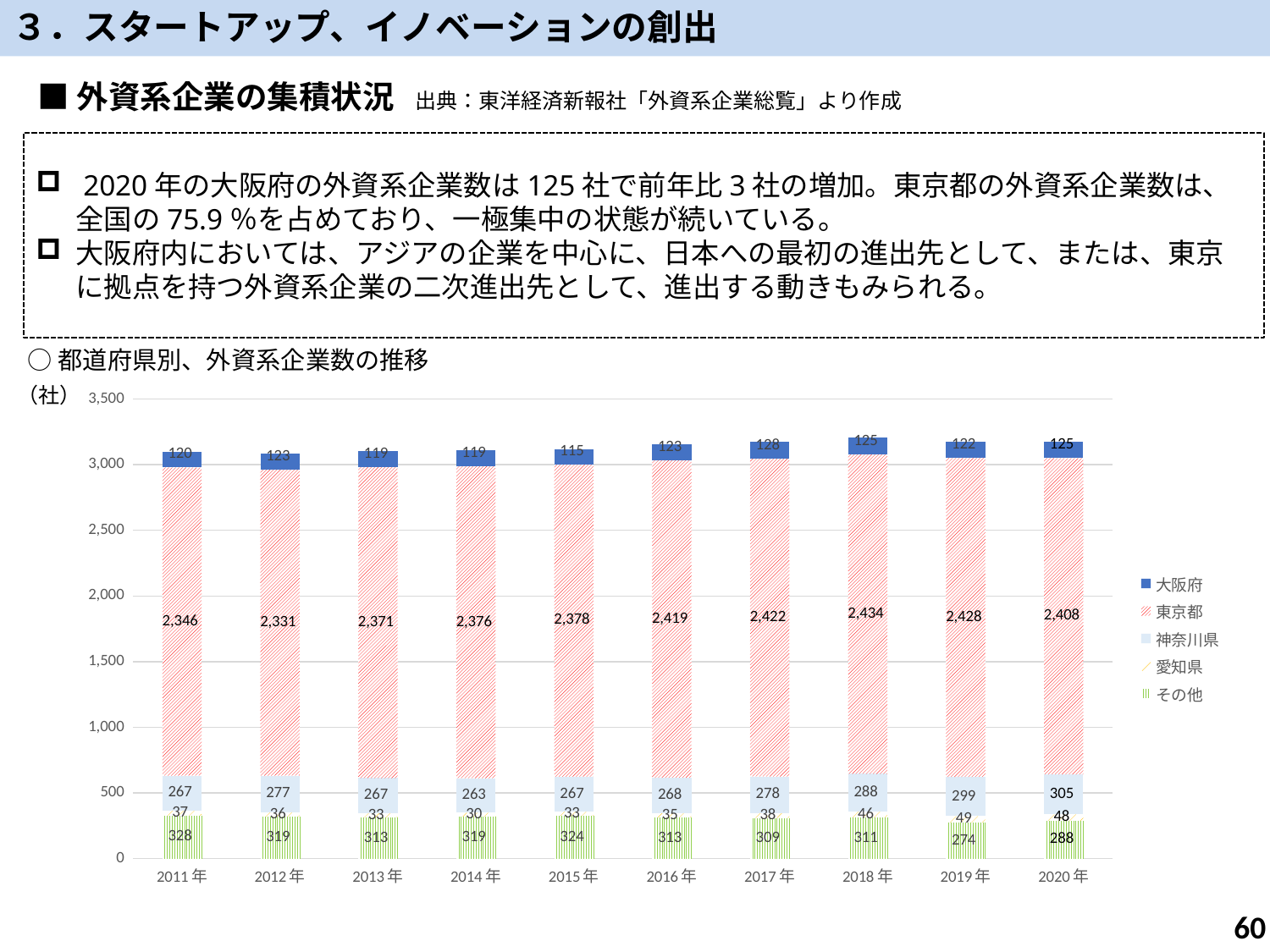
What is the value for その他 in 2019年? 274 In which year is the value for 大阪府 the lowest? 2015年 How many years are shown on the x axis? 10 What kind of chart is shown? Stacked bar chart In which year is the value for 東京都 the highest? 2018年 What is the value for 大阪府 in 2020年? 125 What is the value for 東京都 in 2018年? 2,434 Which is larger, the その他 value in 2011年 or in 2020年? 2011年 How many series does the legend list? 5 What is the difference between the 大阪府 values for 2020年 and 2019年? 3 What is the total of the stacked bar for 2020年? 3,174 What is the value for 神奈川県 in 2011年? 267